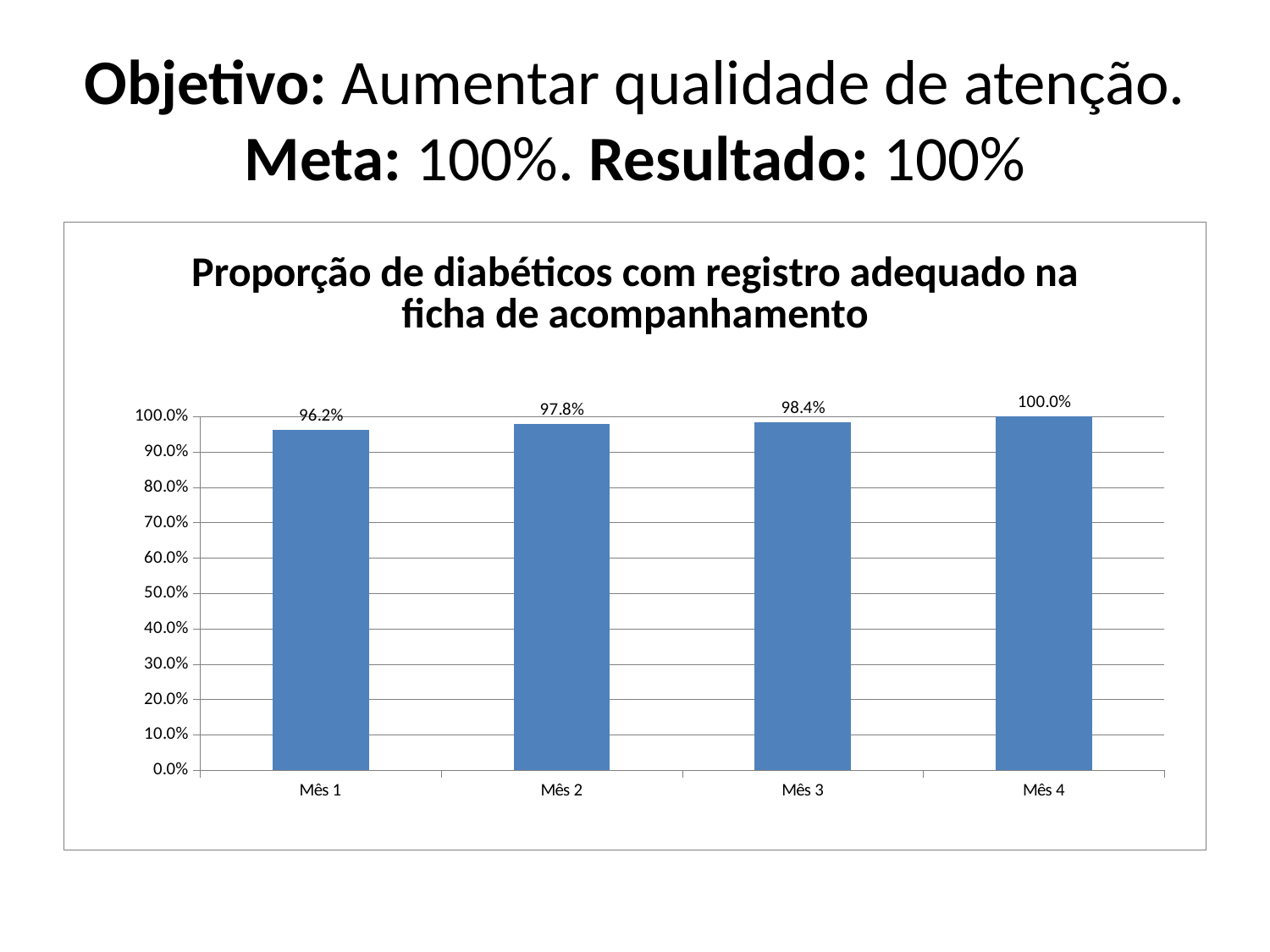
Which is larger, the value for Mês 2 or the value for Mês 3? Mês 3 What is the value for Mês 2? 97.8% How many months are shown on the x axis? 4 Which month has the highest value? Mês 4 What is the value for Mês 1? 96.2% What kind of chart is shown? Bar chart What is the difference between the values for Mês 3 and Mês 2? 0.6% What is the value for Mês 4? 100.0% Do the values rise or fall from Mês 1 to Mês 4? Rise What is the value for Mês 3? 98.4% What is the difference between the values for Mês 4 and Mês 1? 3.8% Which month has the lowest value? Mês 1